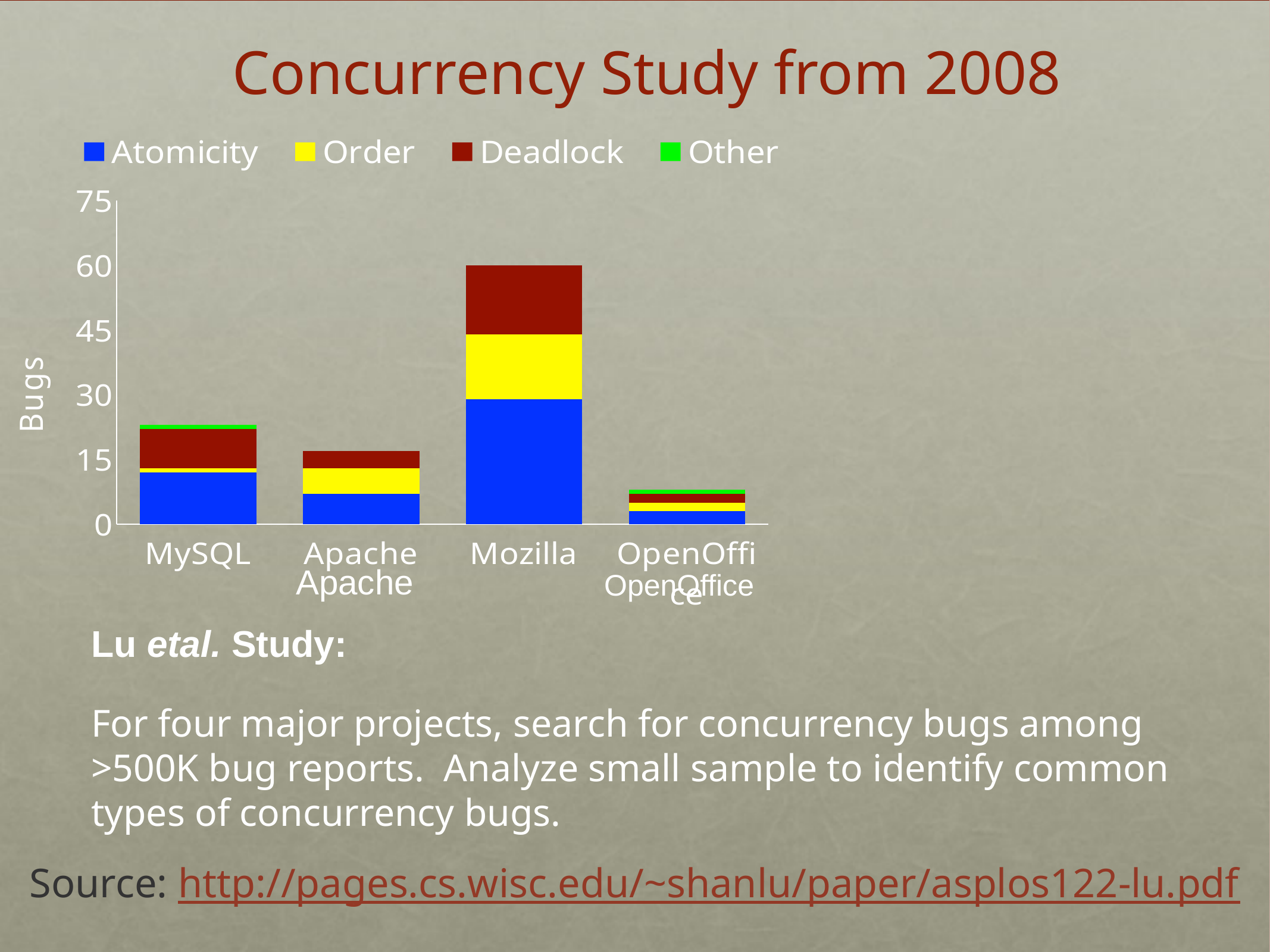
How many projects (categories) are shown on the x axis? 4 How many series does the legend list? 4 Is the total number of bugs for Mozilla greater or less than 45? greater What kind of chart is shown on the slide? stacked bar chart Which project has the tallest stacked bar (most bugs in total)? Mozilla Which project has more total bugs, MySQL or Apache? MySQL Is the Atomicity value for Mozilla greater or less than 15? greater Is the total number of bugs for OpenOffice greater or less than 15? less Which project has the shortest stacked bar (fewest bugs in total)? OpenOffice What is the label on the y axis? Bugs Which series is shown in yellow in the legend? Order